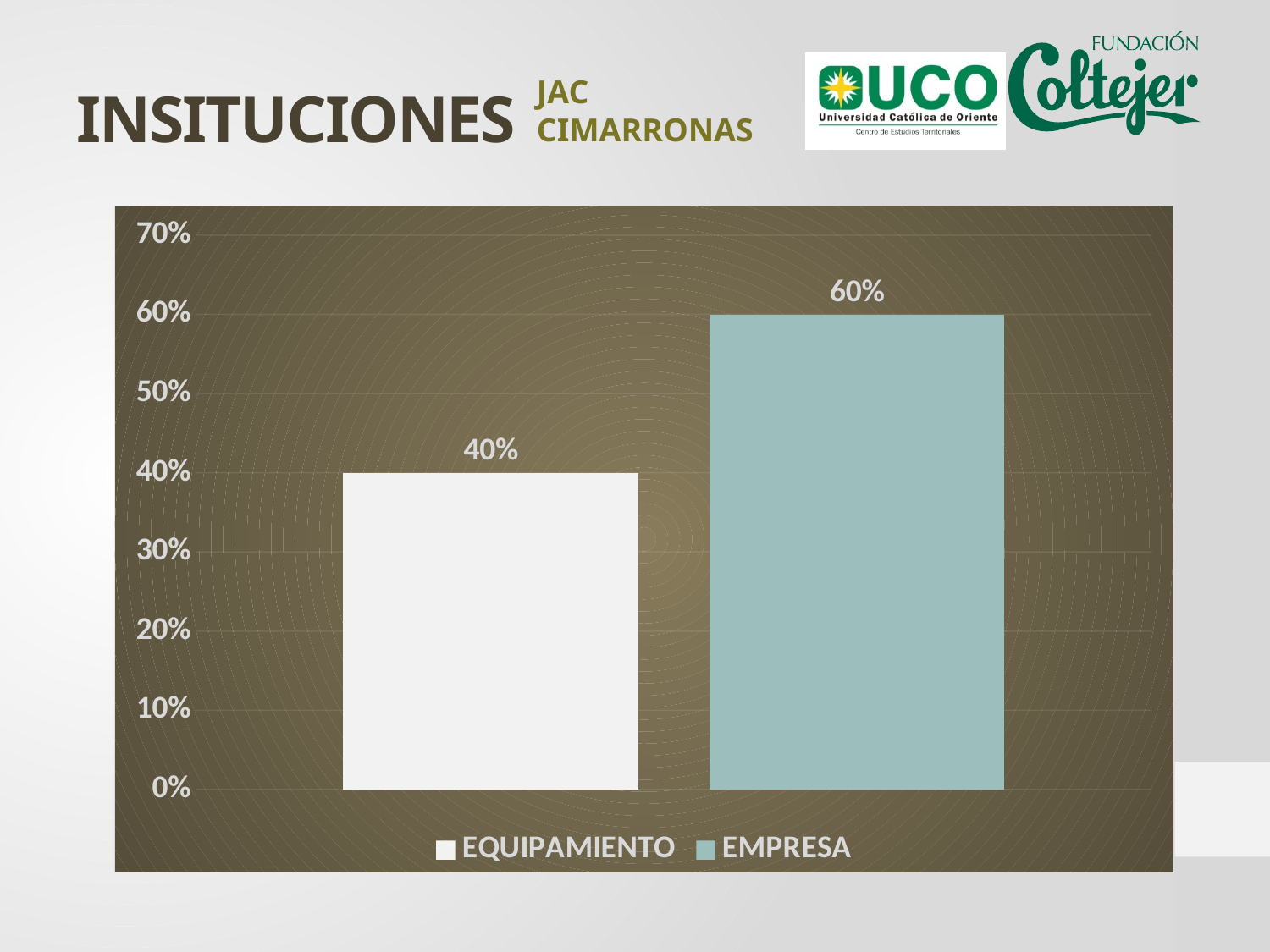
Is the value for EMPRESA greater or less than 50%? greater Which series has the highest value? EMPRESA What is the value for EQUIPAMIENTO? 40% What is the difference between the values for EMPRESA and EQUIPAMIENTO? 20% How many series does the legend list? 2 How many bars are plotted in the chart? 2 What kind of chart is shown on the slide? bar chart What is the highest value shown on the vertical axis? 70% Which series has the lowest value? EQUIPAMIENTO Which is larger, the value for EQUIPAMIENTO or the value for EMPRESA? EMPRESA Is the value for EQUIPAMIENTO greater or less than 50%? less What is the value for EMPRESA? 60%